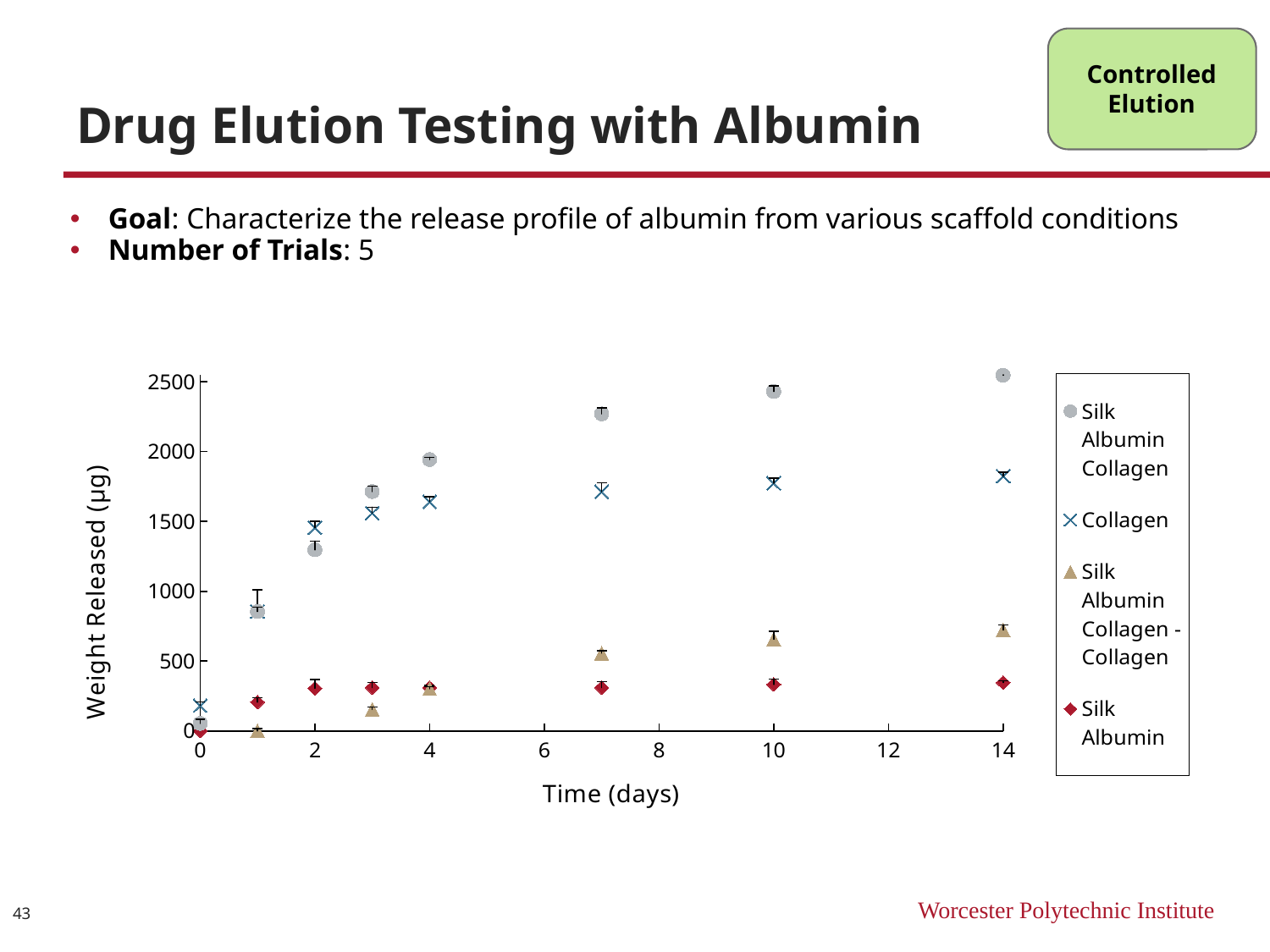
Is the weight released for Silk Albumin at day 14 greater or less than 500? less What is the label of the x axis of the chart? Time (days) Is the weight released for Silk Albumin Collagen - Collagen at day 14 greater or less than 500? greater Which series has the lowest weight released at day 14? Silk Albumin What is the label of the y axis of the chart? Weight Released (µg) What kind of chart is shown on the slide? scatter chart Is the weight released for Collagen at day 14 greater or less than 1500? greater At day 14, which series has the larger weight released: Silk Albumin or Silk Albumin Collagen - Collagen? Silk Albumin Collagen - Collagen Which series has the highest weight released at day 14? Silk Albumin Collagen Does the weight released for Silk Albumin Collagen rise or fall as time increases from day 0 to day 14? rise How many series does the chart legend list? 4